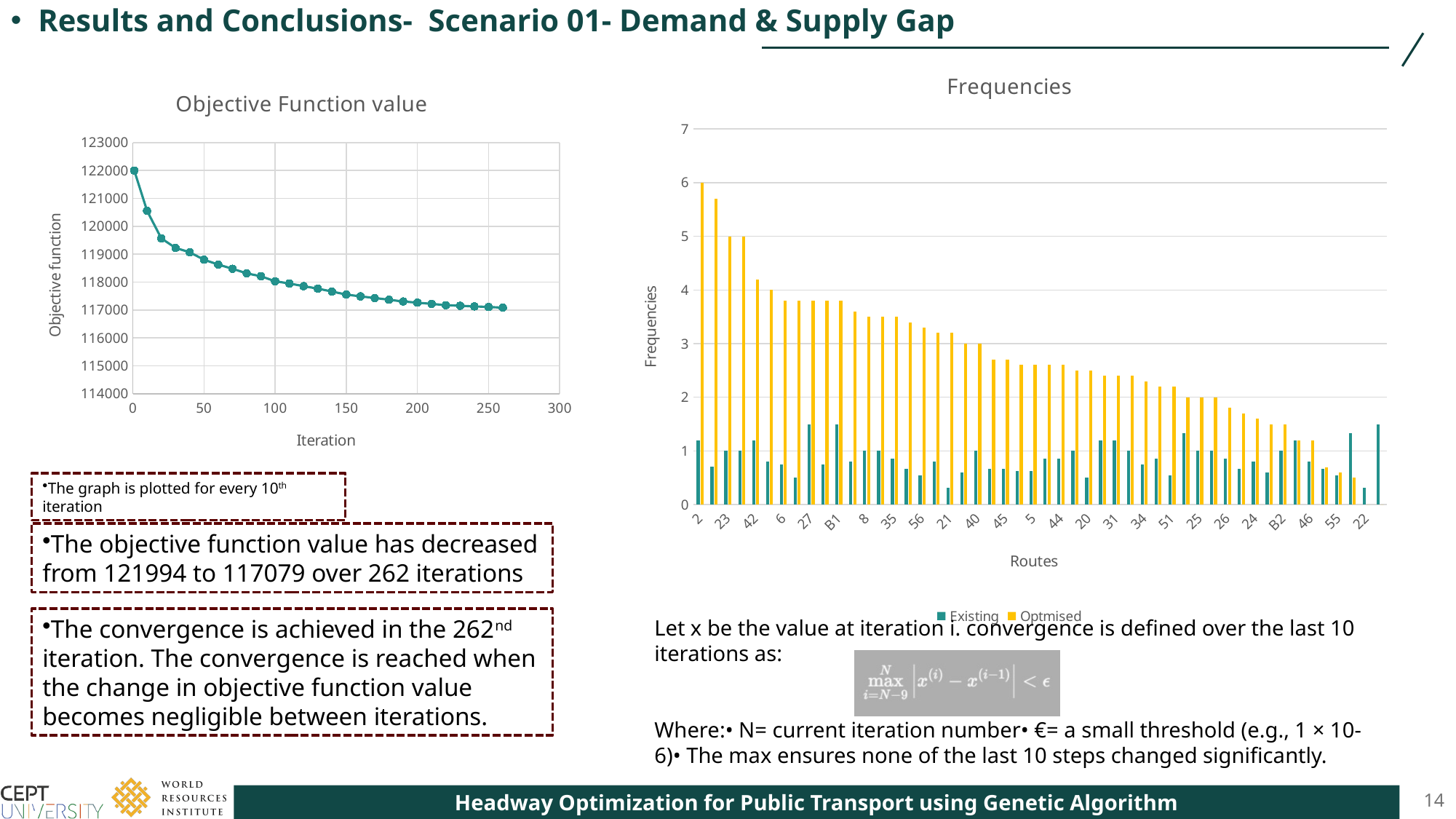
In the 'Frequencies' chart, is the Existing value for route 2 greater or less than 2? less What kind of chart is the 'Frequencies' chart? bar chart What is the x-axis label of the 'Objective Function value' chart? Iteration In the 'Frequencies' chart, which route has the highest Optmised frequency? 2 In the 'Objective Function value' chart, do the values rise or fall as the iteration number increases? fall In the 'Frequencies' chart, do the Optmised bars generally rise or fall from left to right along the x axis? fall In the 'Frequencies' chart, is the Optmised value for route 2 greater or less than 5? greater What are the two series named in the legend of the 'Frequencies' chart? Existing and Optmised What kind of chart is the 'Objective Function value' chart? line chart In the 'Objective Function value' chart, is the value at iteration 0 greater or less than 121000? greater How many series does the legend of the 'Frequencies' chart list? 2